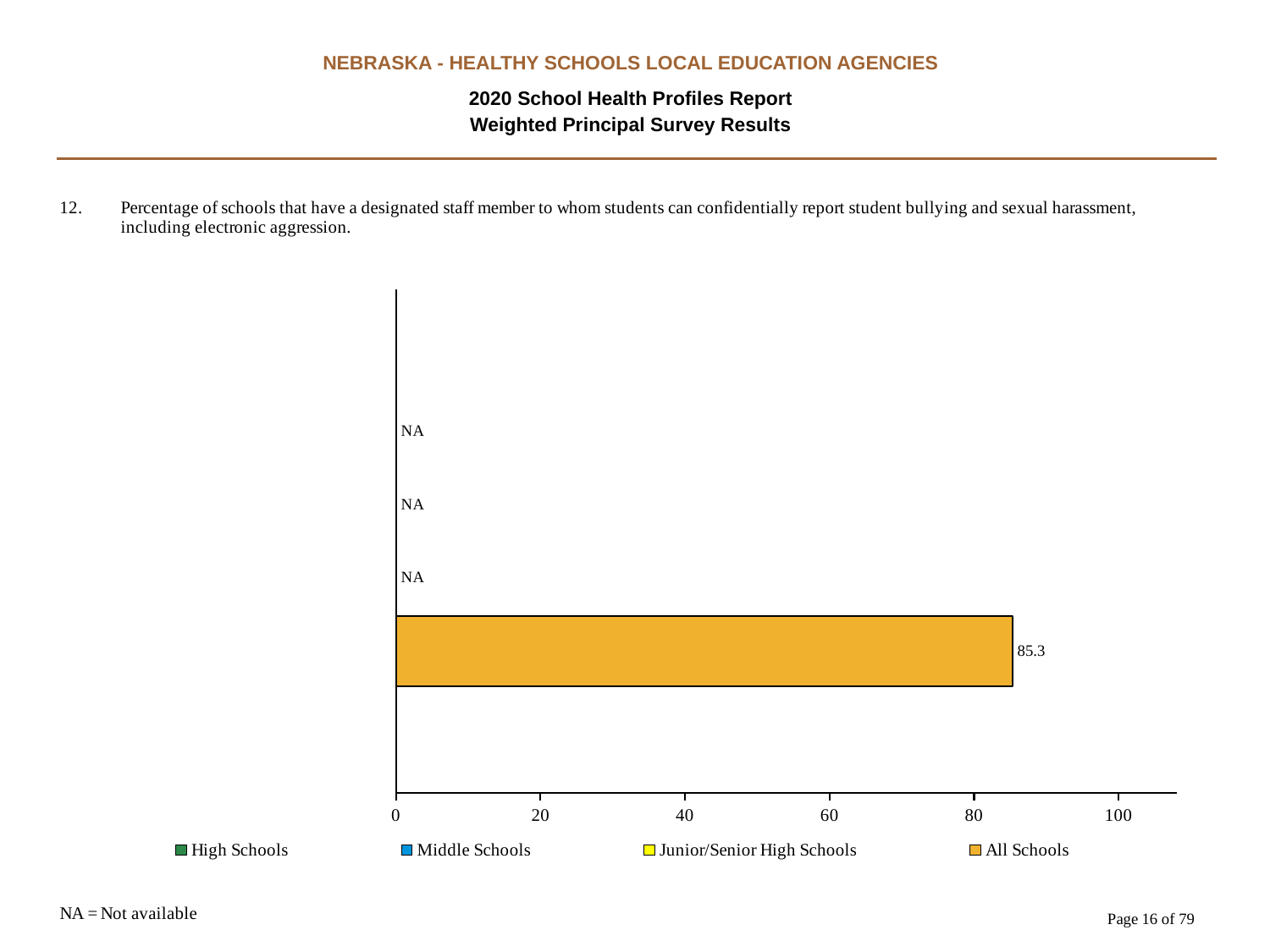
What kind of chart is shown on the slide? bar chart What is shown for Middle Schools on the chart? NA Is the value for All Schools greater or less than 80? greater Is the value for All Schools greater or less than 100? less How many series have a numeric value plotted on the chart? 1 How many series does the legend list? 4 What is the value for All Schools? 85.3 What is shown for Junior/Senior High Schools on the chart? NA What is shown for High Schools on the chart? NA What is the highest value shown on the x axis? 100 Which series is the only one with a plotted bar? All Schools